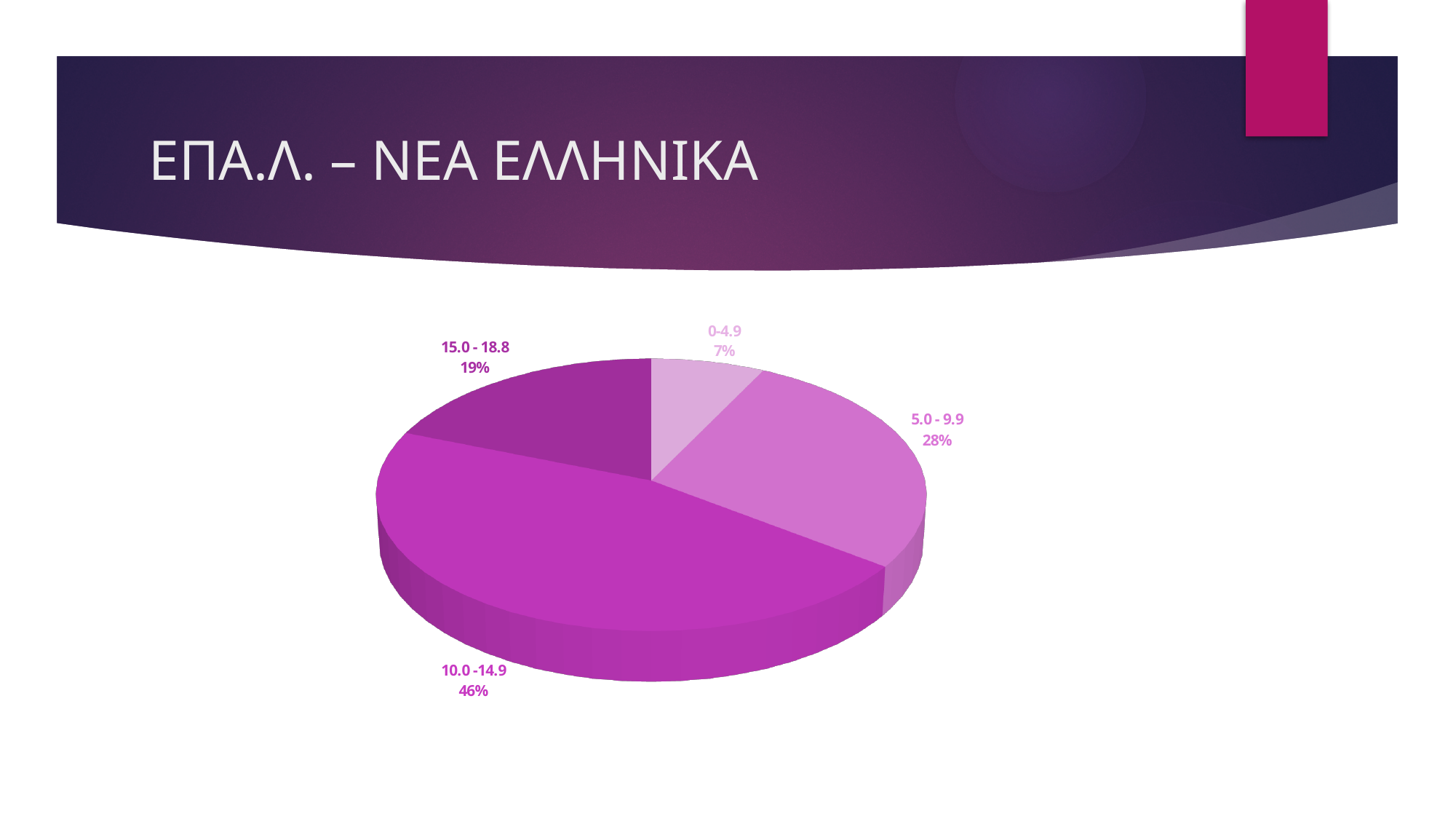
Which category has the largest slice of the pie? 10.0 - 14.9 What share of the pie does the 15.0 - 18.8 slice represent? 19% What kind of chart is shown on the slide? pie chart Which slice is larger, 15.0 - 18.8 or 5.0 - 9.9? 5.0 - 9.9 What is the difference in percentage points between the 15.0 - 18.8 slice and the 0-4.9 slice? 12 What share of the pie does the 0-4.9 slice represent? 7% What is the difference in percentage points between the 10.0 - 14.9 slice and the 5.0 - 9.9 slice? 18 Which category has the smallest slice of the pie? 0-4.9 How many slices does the pie chart have? 4 What share of the pie does the 5.0 - 9.9 slice represent? 28% What is the title of the slide containing the pie chart? ΕΠΑ.Λ. – ΝΕΑ ΕΛΛΗΝΙΚΑ